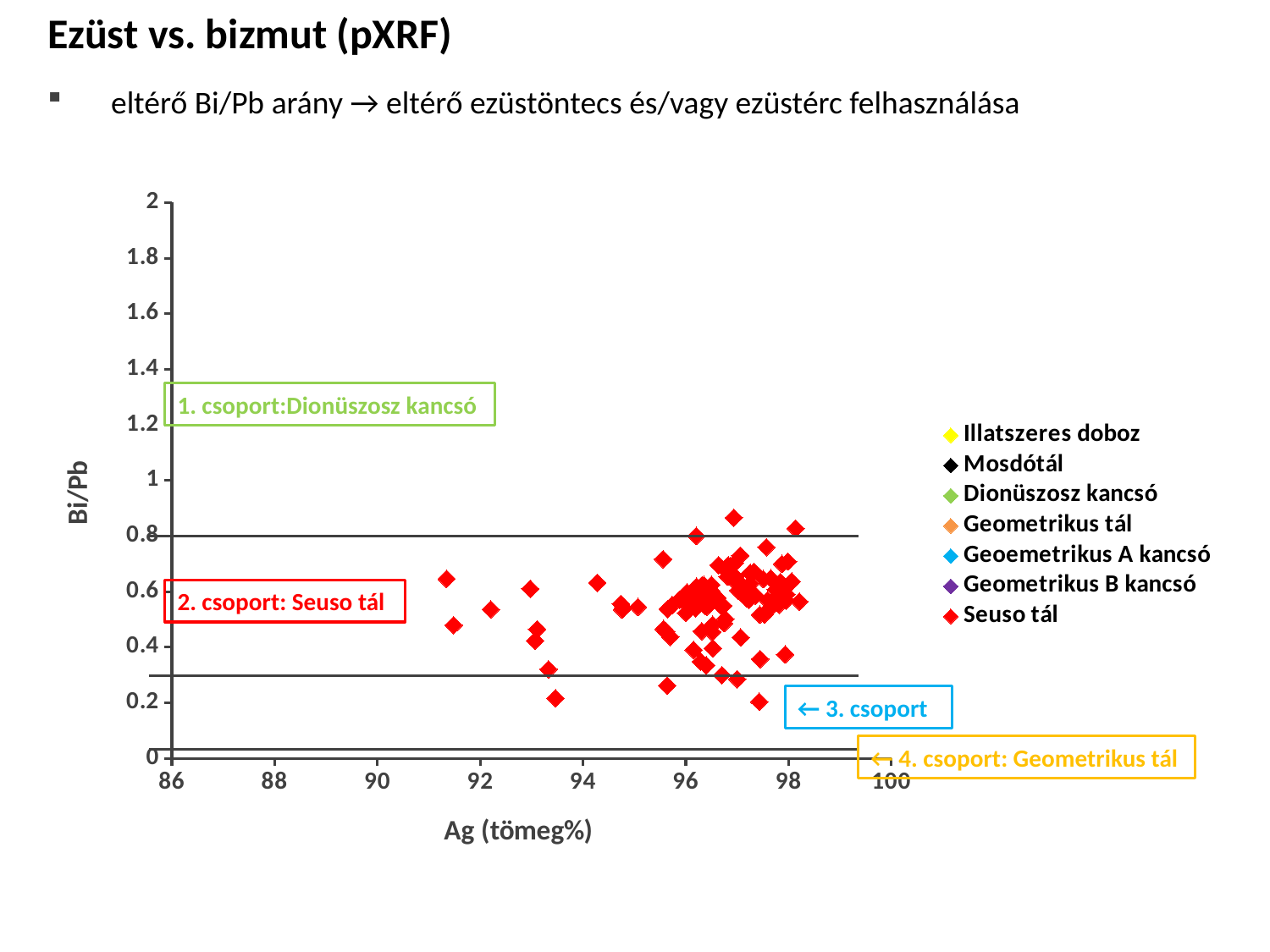
Is the highest Ag (tömeg%) value among the Seuso tál points greater or less than 96? greater Is the lowest Bi/Pb value among the Seuso tál points greater or less than 0.4? less What is the label of the x axis? Ag (tömeg%) How many series does the chart's legend list? 7 Are all the Seuso tál points plotted at Ag (tömeg%) values greater or less than 100? less What is the label of the y axis? Bi/Pb What kind of chart is shown on the slide? scatter chart